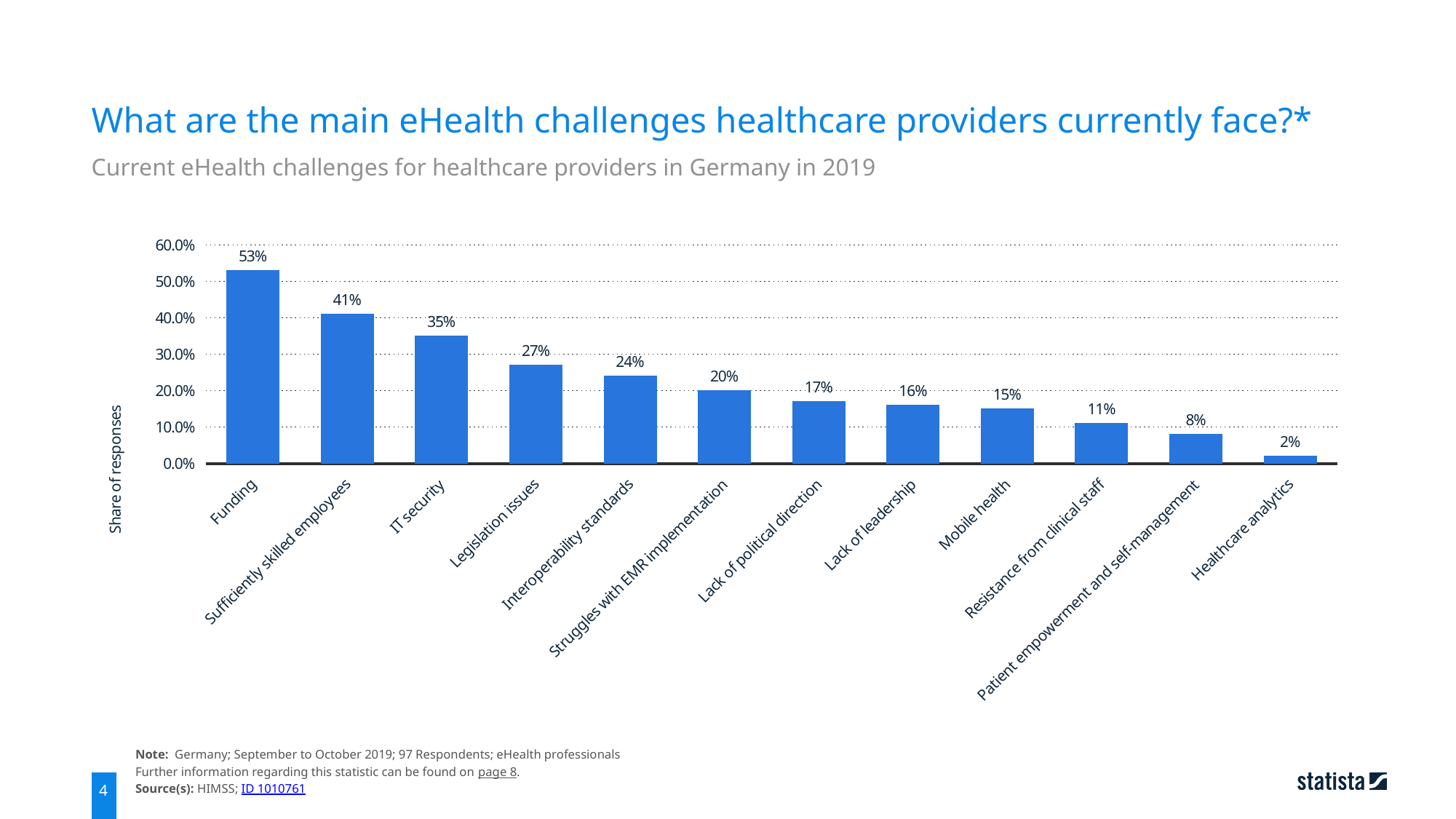
What kind of chart is shown on the slide? Bar chart What is the difference in share of responses between Funding and Sufficiently skilled employees? 12% What share of responses is shown for Funding? 53% Which has a larger share of responses, Legislation issues or Mobile health? Legislation issues What share of responses is shown for Resistance from clinical staff? 11% Which challenge has the highest share of responses? Funding What share of responses is shown for Struggles with EMR implementation? 20% How many challenge categories are shown in the chart? 12 What share of responses is shown for IT security? 35% Is the value for Interoperability standards greater or less than 20.0%? greater Which challenge has the lowest share of responses? Healthcare analytics What is the label of the vertical axis? Share of responses